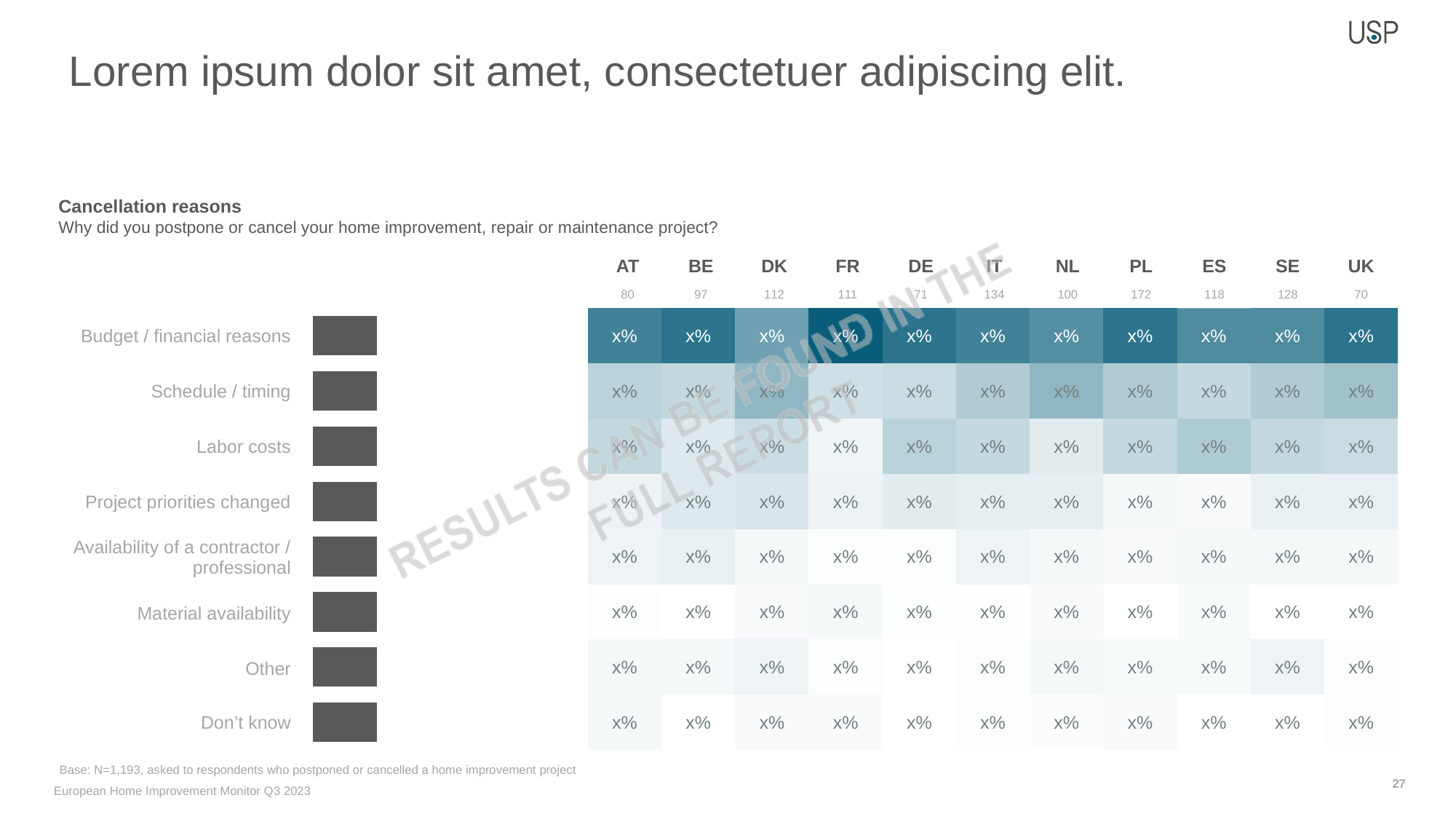
What kind of chart is shown on the left of the slide next to the cancellation reasons? bar chart How many countries are shown as columns in the table to the right of the bar chart? 11 What is the difference between the numbers printed under the PL and UK column headers? 102 What placeholder value is shown in the cells of the country table? x% Which country column has the lowest number printed under its header? UK What number is printed under the PL column header in the table? 172 What number is printed under the UK column header in the table? 70 Which country column has the highest number printed under its header? PL What is the title of the chart? Cancellation reasons What number is printed under the DE column header in the table? 71 How many cancellation reasons (categories) are listed in the chart? 8 Which is larger, the number printed under the DK header or the number under the ES header? ES